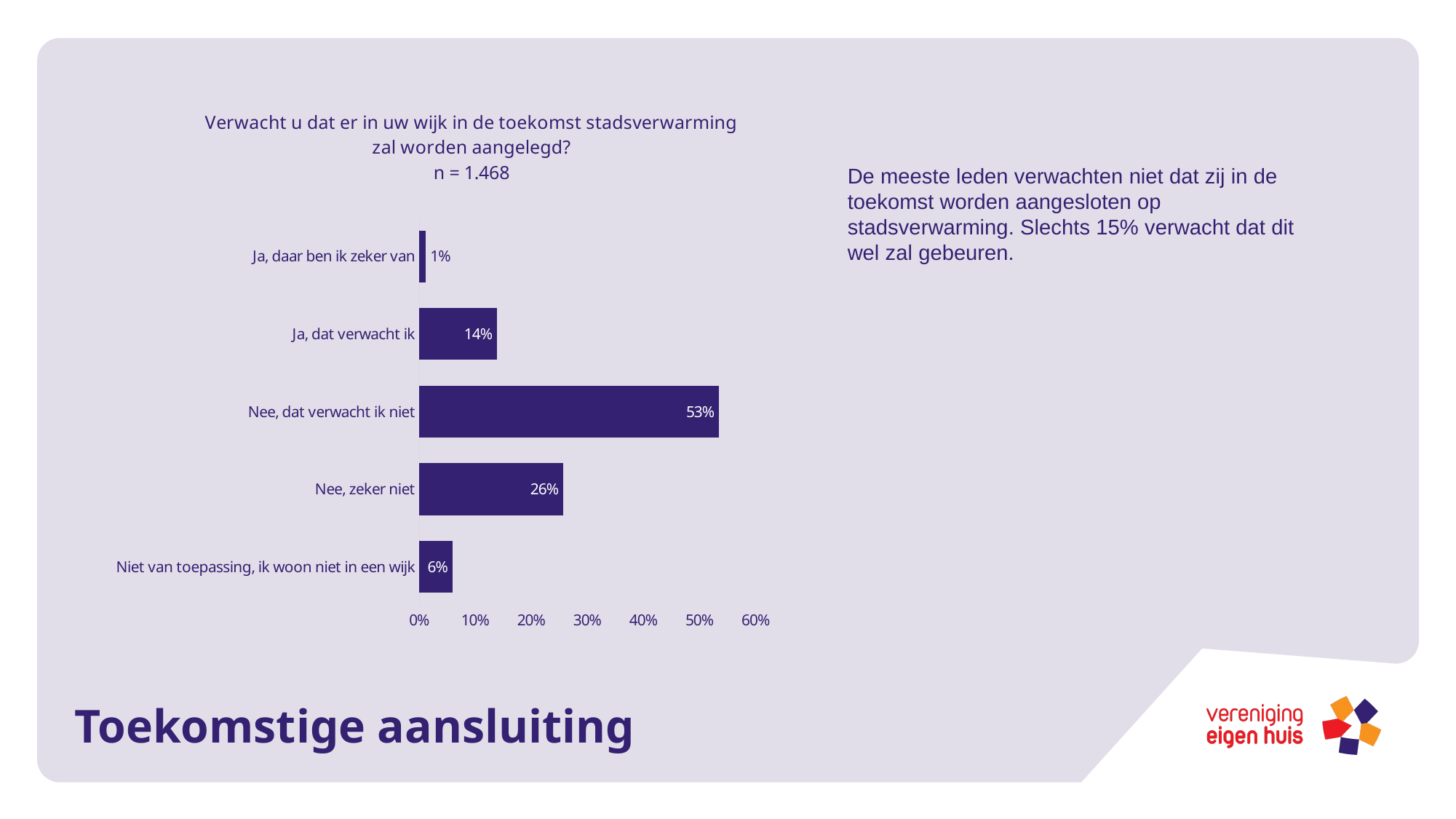
What is the value for "Niet van toepassing, ik woon niet in een wijk"? 6% What is the difference between "Nee, dat verwacht ik niet" and "Nee, zeker niet"? 27% What is the sample size (n) stated under the chart title? 1.468 Which category has the lowest value? Ja, daar ben ik zeker van What is the value for "Nee, zeker niet"? 26% How many categories are shown in the chart? 5 What is the value for "Nee, dat verwacht ik niet"? 53% Which category has the highest value? Nee, dat verwacht ik niet Is the value for "Nee, dat verwacht ik niet" greater or less than 50%? greater Which is larger: "Ja, dat verwacht ik" or "Niet van toepassing, ik woon niet in een wijk"? Ja, dat verwacht ik What is the value for "Ja, dat verwacht ik"? 14% What kind of chart is shown on the slide? Bar chart